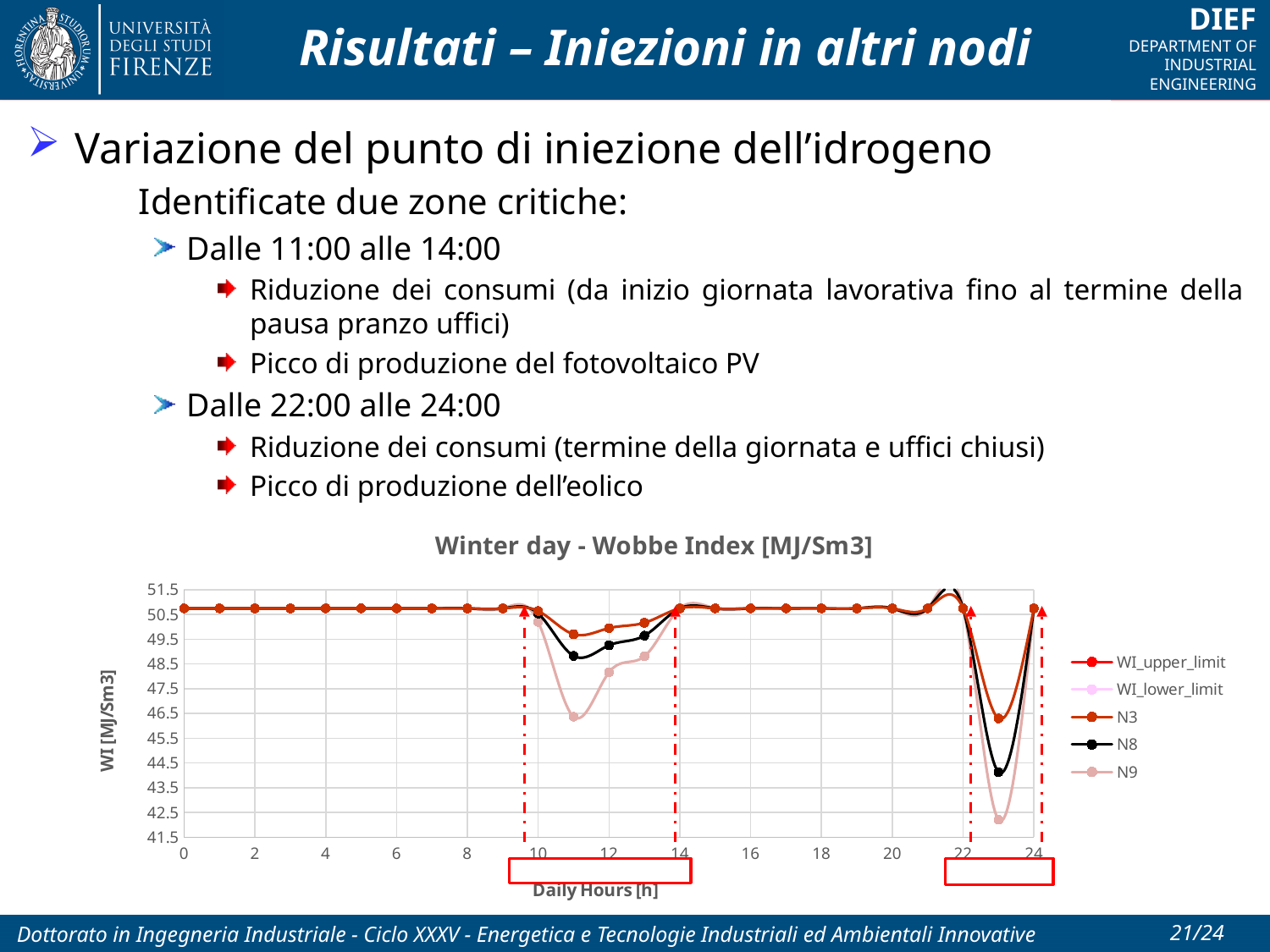
Do the values of N9 rise or fall between hour 10 and hour 11? fall Is the value for N9 at hour 11 greater or less than 47.5? less How many series does the chart legend list? 5 Is the value for N3 at hour 23 greater or less than 47.5? less At hour 23, which series has the larger value, N8 or N9? N8 Is the value for N9 at hour 23 greater or less than 43.5? less Which series reaches the lowest value at hour 23? N9 What kind of chart is shown on the slide? line chart At hour 11, which series has the larger value, N3 or N9? N3 What is the title of the chart? Winter day - Wobbe Index [MJ/Sm3] What is the label of the x axis of the chart? Daily Hours [h]